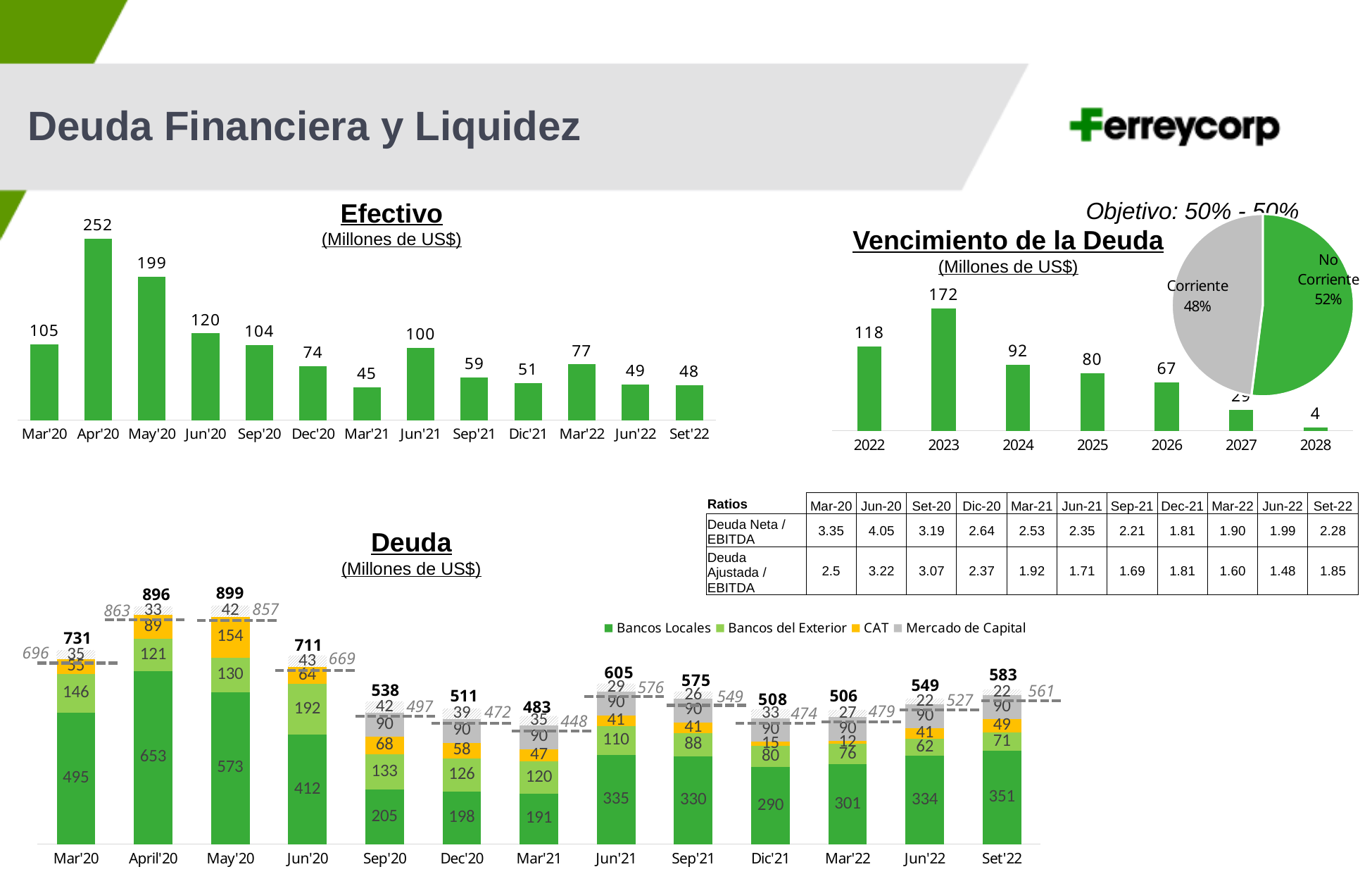
How many series does the legend of the Deuda chart list? 4 In the Vencimiento de la Deuda chart, what is the value for 2025? 80 What kind of chart is the Efectivo chart? Bar chart In the Vencimiento de la Deuda chart, which year has the highest value? 2023 In the pie chart next to Vencimiento de la Deuda, what share is Corriente? 48% In the Vencimiento de la Deuda chart, is the value for 2024 larger or smaller than the value for 2026? larger In the Deuda chart, what is the total of the stacked bar for Set'22? 583 In the Deuda chart, what is the Bancos Locales value for April'20? 653 In the Efectivo chart, which period has the lowest value? Mar'21 How many bars are shown in the Efectivo chart? 13 In the Efectivo chart, what is the difference between the values for May'20 and Jun'20? 79 In the Efectivo chart, what is the value for Apr'20? 252